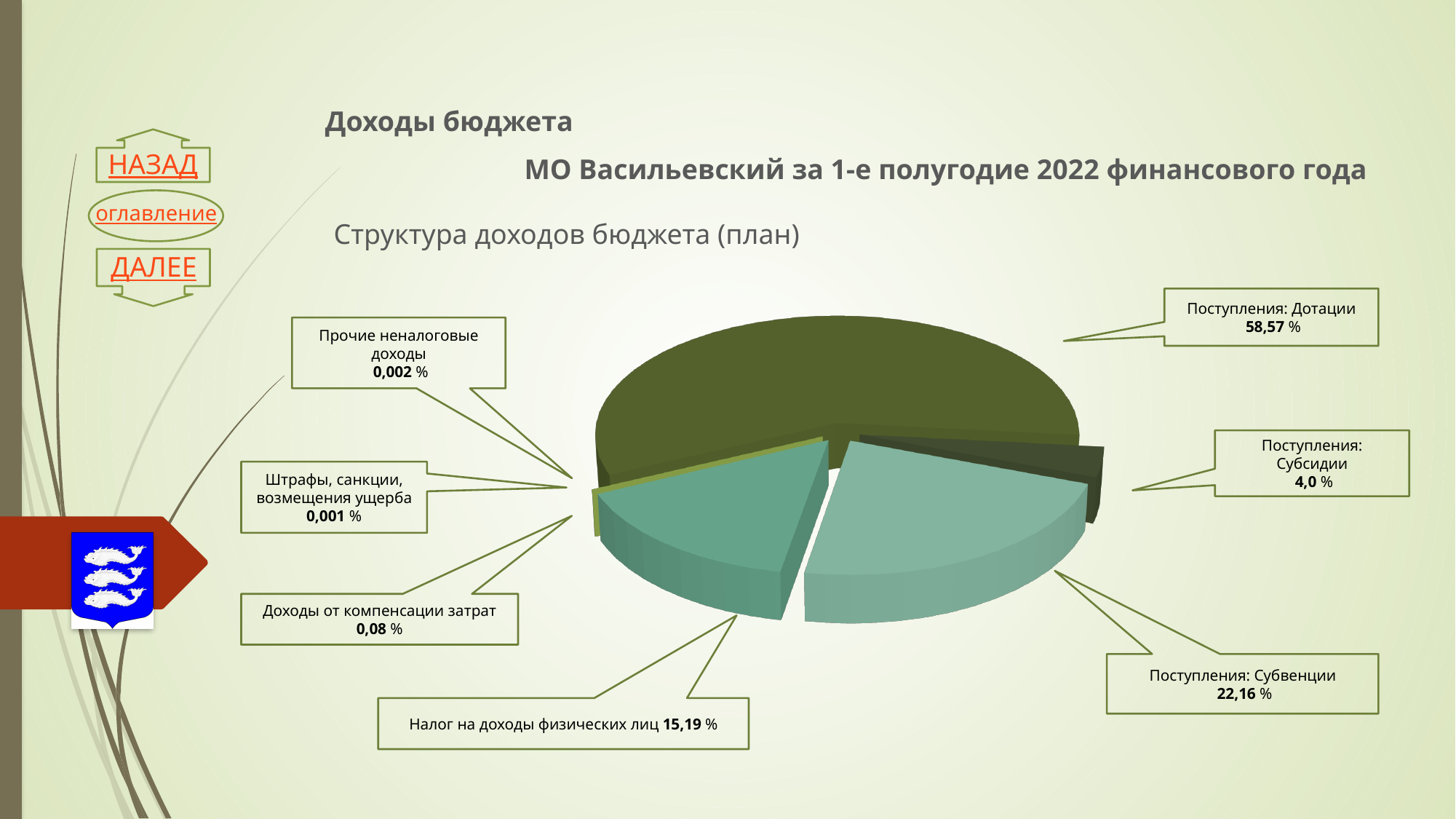
Which category has the largest share in the pie chart? Поступления: Дотации What kind of chart is shown on the slide? Pie chart How many categories are labelled in the pie chart? 7 What is the share of Поступления: Субсидии in the pie chart? 4,0 % What is the share of Налог на доходы физических лиц in the pie chart? 15,19 % What is the share of Штрафы, санкции, возмещения ущерба in the pie chart? 0,001 % Which category has the smallest share in the pie chart? Штрафы, санкции, возмещения ущерба What is the share of Поступления: Дотации in the pie chart? 58,57 % What is the share of Доходы от компенсации затрат in the pie chart? 0,08 % Which is larger: the share of Поступления: Субвенции or the share of Налог на доходы физических лиц? Поступления: Субвенции What is the share of Поступления: Субвенции in the pie chart? 22,16 % What is the title of the chart on the slide? Структура доходов бюджета (план)